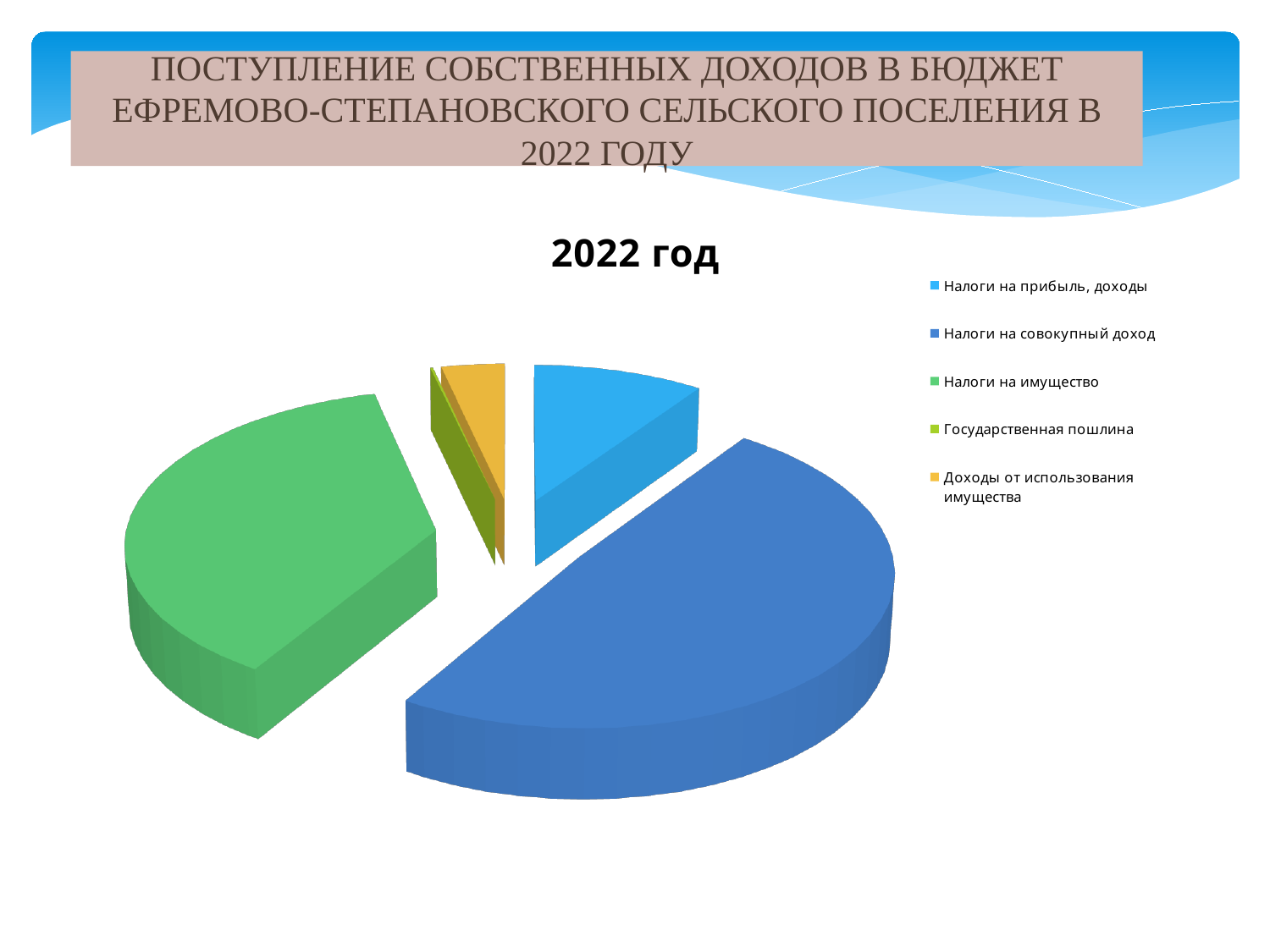
Which slice is larger: Налоги на имущество or Налоги на прибыль, доходы? Налоги на имущество What is the title of the chart? 2022 год How many categories does the pie chart have? 5 Which slice is larger: Налоги на имущество or Государственная пошлина? Налоги на имущество Which slice is larger: Налоги на совокупный доход or Налоги на имущество? Налоги на совокупный доход Which category has the largest slice of the pie? Налоги на совокупный доход Which category is shown in green in the legend? Налоги на имущество What kind of chart is shown on the slide? pie chart Which category is listed last in the legend? Доходы от использования имущества